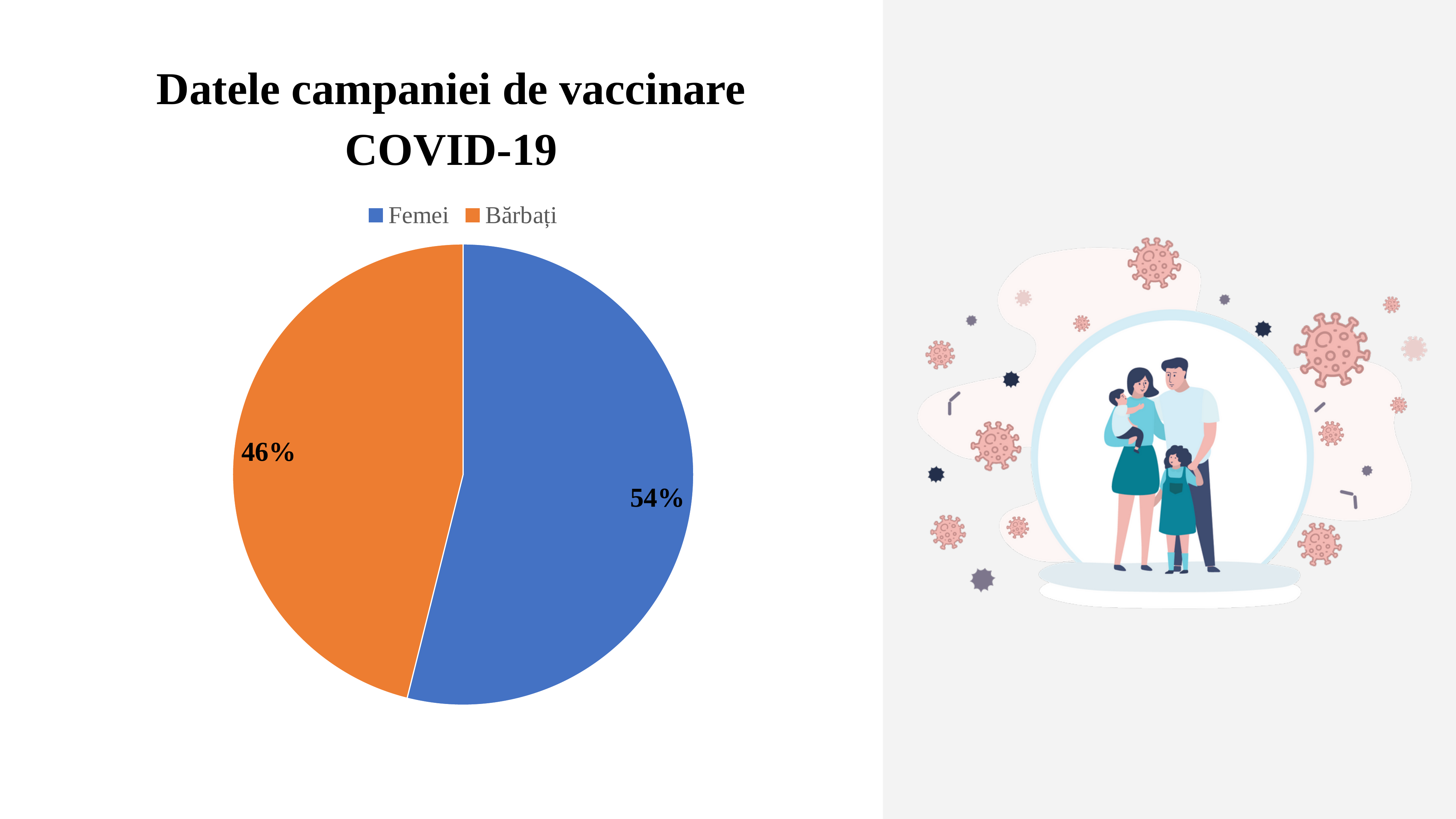
What percentage of the pie is Bărbați? 46% What colour is the Bărbați slice? orange What is the title of the chart? Datele campaniei de vaccinare COVID-19 Is the share for Femei greater or less than 50%? greater Which is larger, the share for Femei or the share for Bărbați? Femei How many entries does the legend list? 2 What type of chart is shown on the slide? pie chart How many slices does the pie chart have? 2 What is the difference in percentage points between Femei and Bărbați? 8 Which category has the smallest share of the pie? Bărbați What percentage of the pie is Femei? 54% Which category has the largest share of the pie? Femei